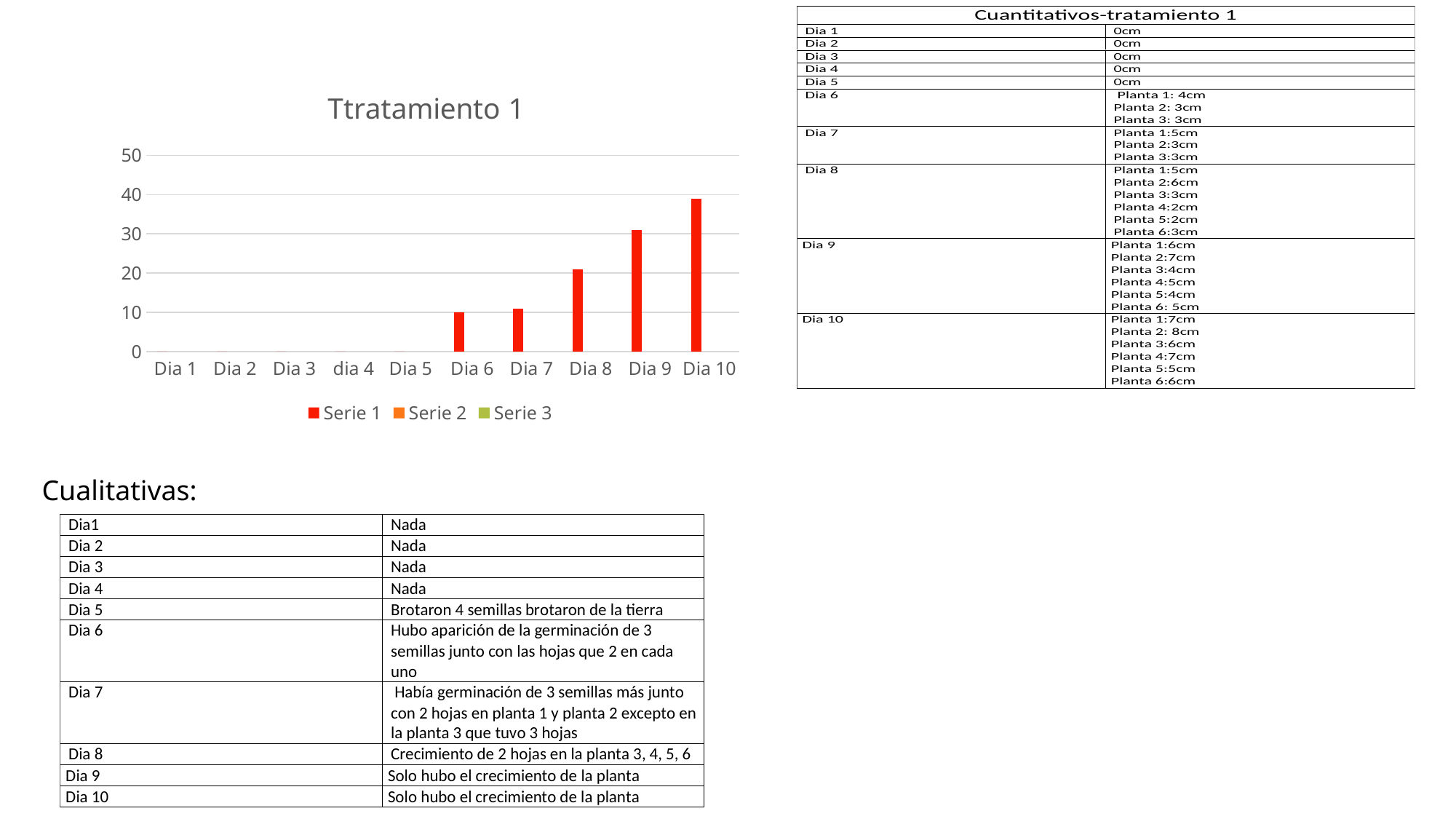
Do the bar values rise or fall from Dia 6 to Dia 10? rise What kind of chart is shown on the slide? Bar chart How many series does the chart legend list? 3 Which is larger, the value for Dia 8 or the value for Dia 9? Dia 9 Is the value for Dia 9 greater or less than 40? less How many categories are shown on the x axis of the chart? 10 Is the value for Dia 7 greater or less than 20? less What is the title of the chart? Ttratamiento 1 What colour are the Serie 1 bars in the chart? Red Which day has the highest bar in the chart? Dia 10 Is the value for Dia 10 greater or less than 30? greater